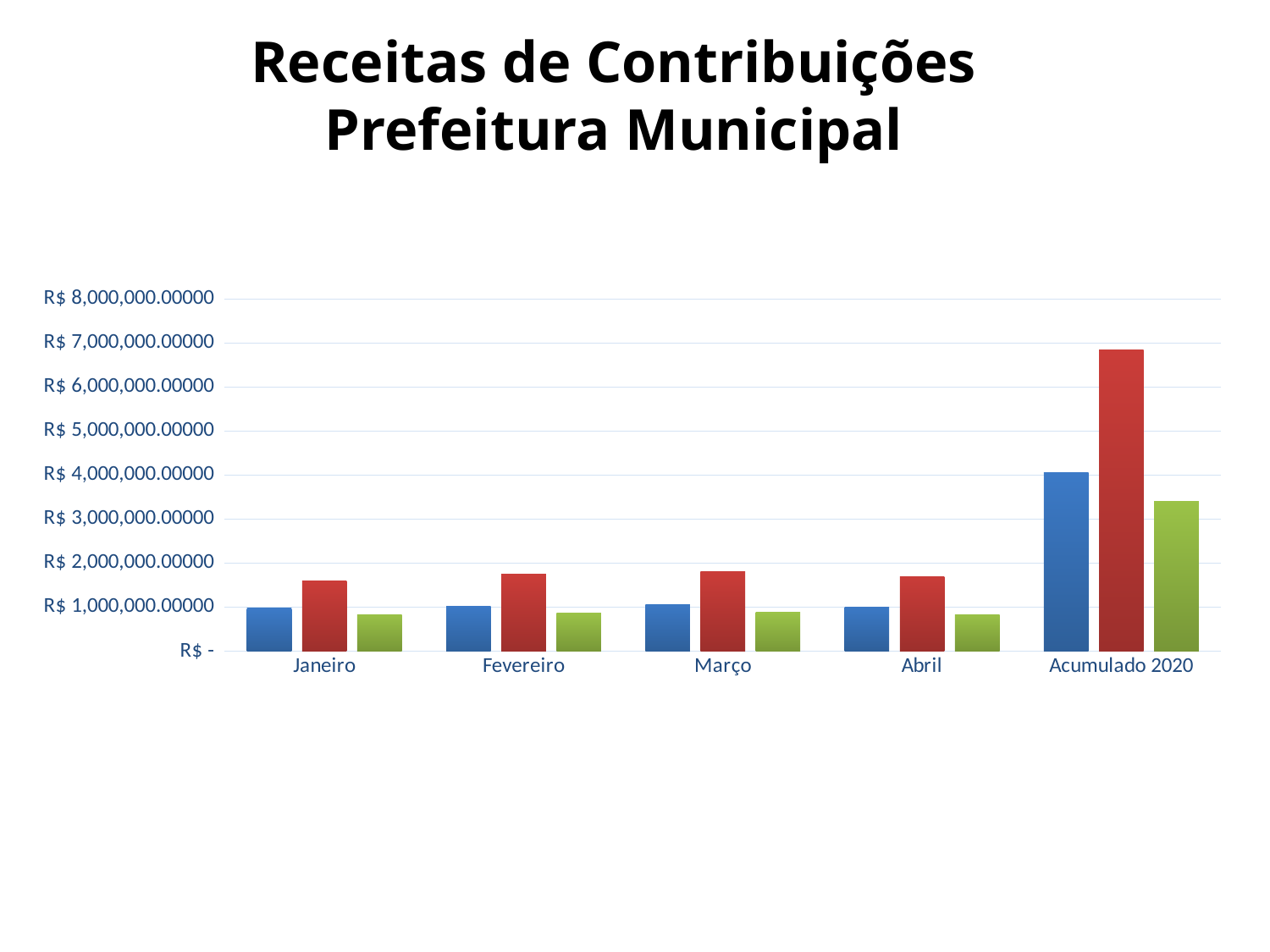
For Janeiro, which is larger: the blue bar or the red bar? the red bar How many categories are shown on the x axis? 5 Is the value of the green bar for Acumulado 2020 greater or less than R$ 3,000,000.00000? greater For Acumulado 2020, which is larger: the red bar or the green bar? the red bar How many bars are plotted for each category? 3 Is the value of the red bar for Março greater or less than R$ 2,000,000.00000? less Is the value of the red bar for Acumulado 2020 greater or less than R$ 6,000,000.00000? greater What is the title of the chart? Receitas de Contribuições Prefeitura Municipal What kind of chart is shown on the slide? bar chart Which category has the tallest bar in the chart? Acumulado 2020